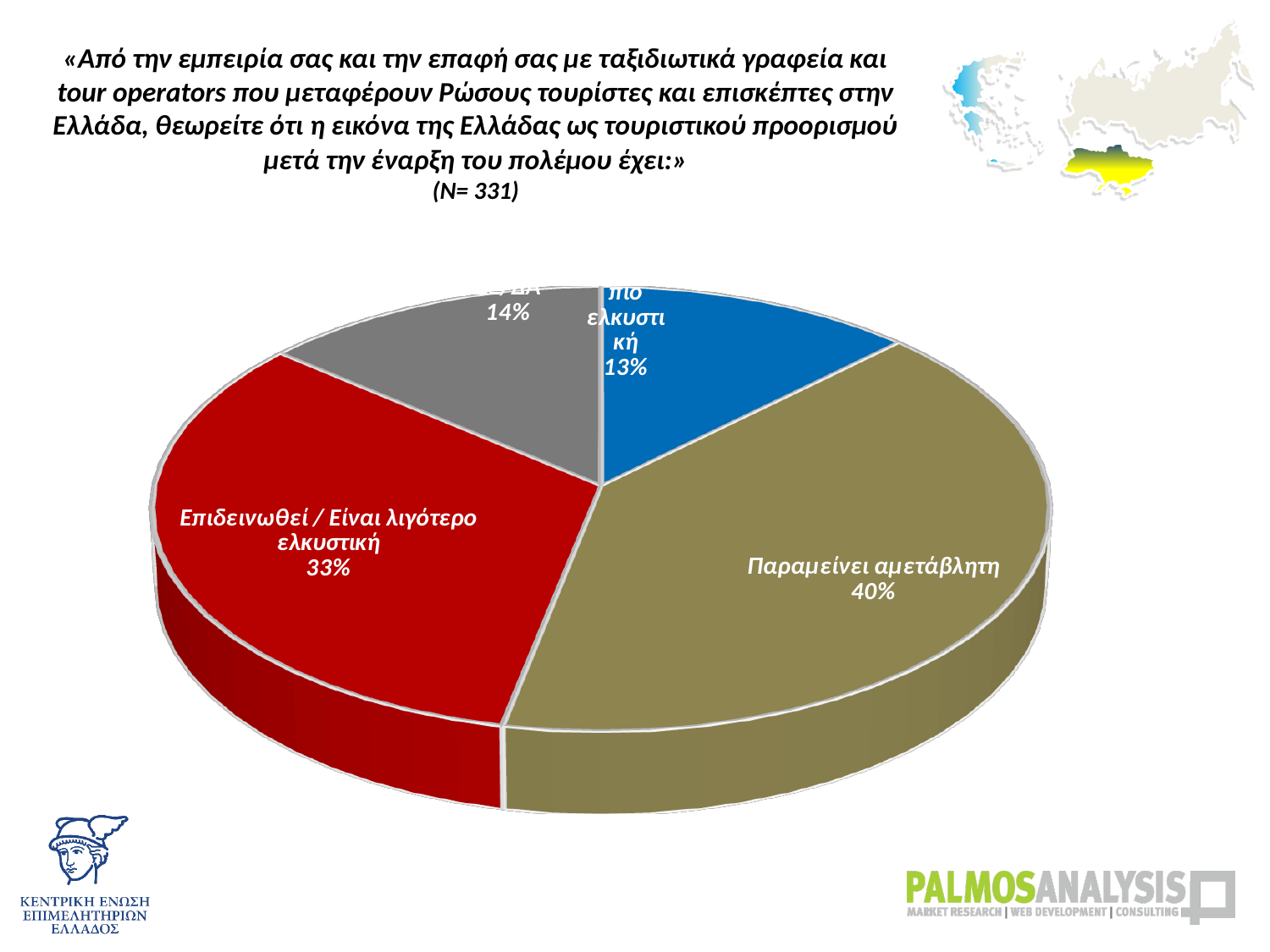
What is the difference in percentage points between "Παραμείνει αμετάβλητη" and "Επιδεινωθεί / Είναι λιγότερο ελκυστική"? 7 percentage points What colour is the slice for "Επιδεινωθεί / Είναι λιγότερο ελκυστική"? red What percentage of respondents answered "Επιδεινωθεί / Είναι λιγότερο ελκυστική"? 33% What type of chart is shown on the slide? pie chart Which response has the smallest share of the pie? πιο ελκυστική What is the sample size (N) stated on the slide? 331 Which response has the largest share of the pie? Παραμείνει αμετάβλητη How many slices does the pie chart have? 4 What percentage is shown for the blue slice labelled "πιο ελκυστική"? 13% Which is larger: the share for "Επιδεινωθεί / Είναι λιγότερο ελκυστική" or the share for "Παραμείνει αμετάβλητη"? Παραμείνει αμετάβλητη What percentage is shown on the grey slice of the pie chart? 14% What percentage of respondents answered "Παραμείνει αμετάβλητη"? 40%